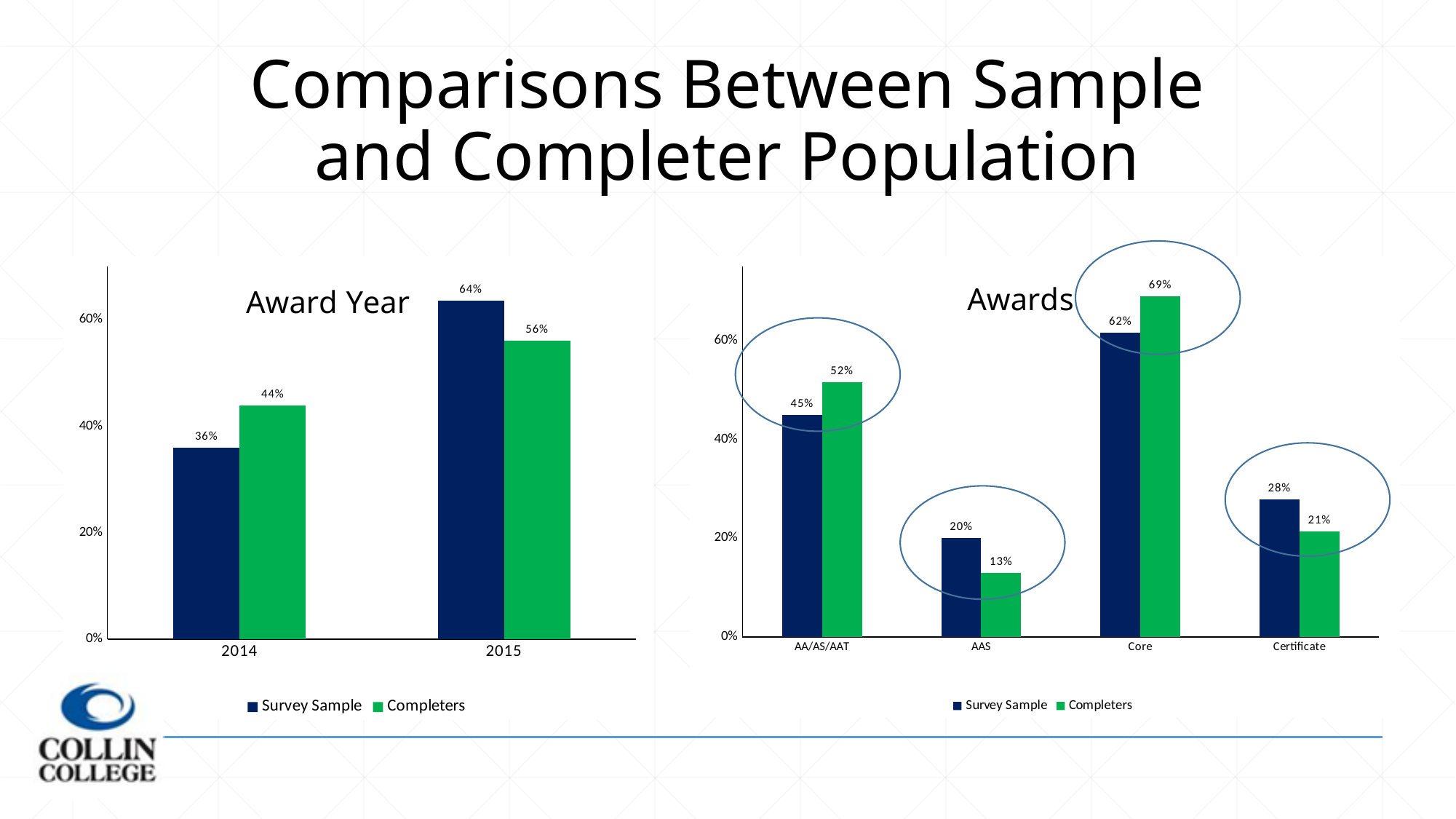
In the Award Year chart, what is the difference between the Survey Sample and Completers values for 2015? 8% In the Award Year chart, which is larger for 2014: Survey Sample or Completers? Completers In the Awards chart, what is the difference between the Completers and Survey Sample values for AA/AS/AAT? 7% In the Award Year chart, what is the Completers value for 2015? 56% In the Awards chart, what is the Survey Sample value for AAS? 20% In the Awards chart, what is the Completers value for Core? 69% How many series does the legend of the Award Year chart list? 2 How many categories are shown on the x axis of the Awards chart? 4 In the Awards chart, which category has the lowest Completers value? AAS What type of chart is the Awards chart? Bar chart In the Award Year chart, what is the Survey Sample value for 2014? 36% In the Awards chart, which category has the highest Survey Sample value? Core